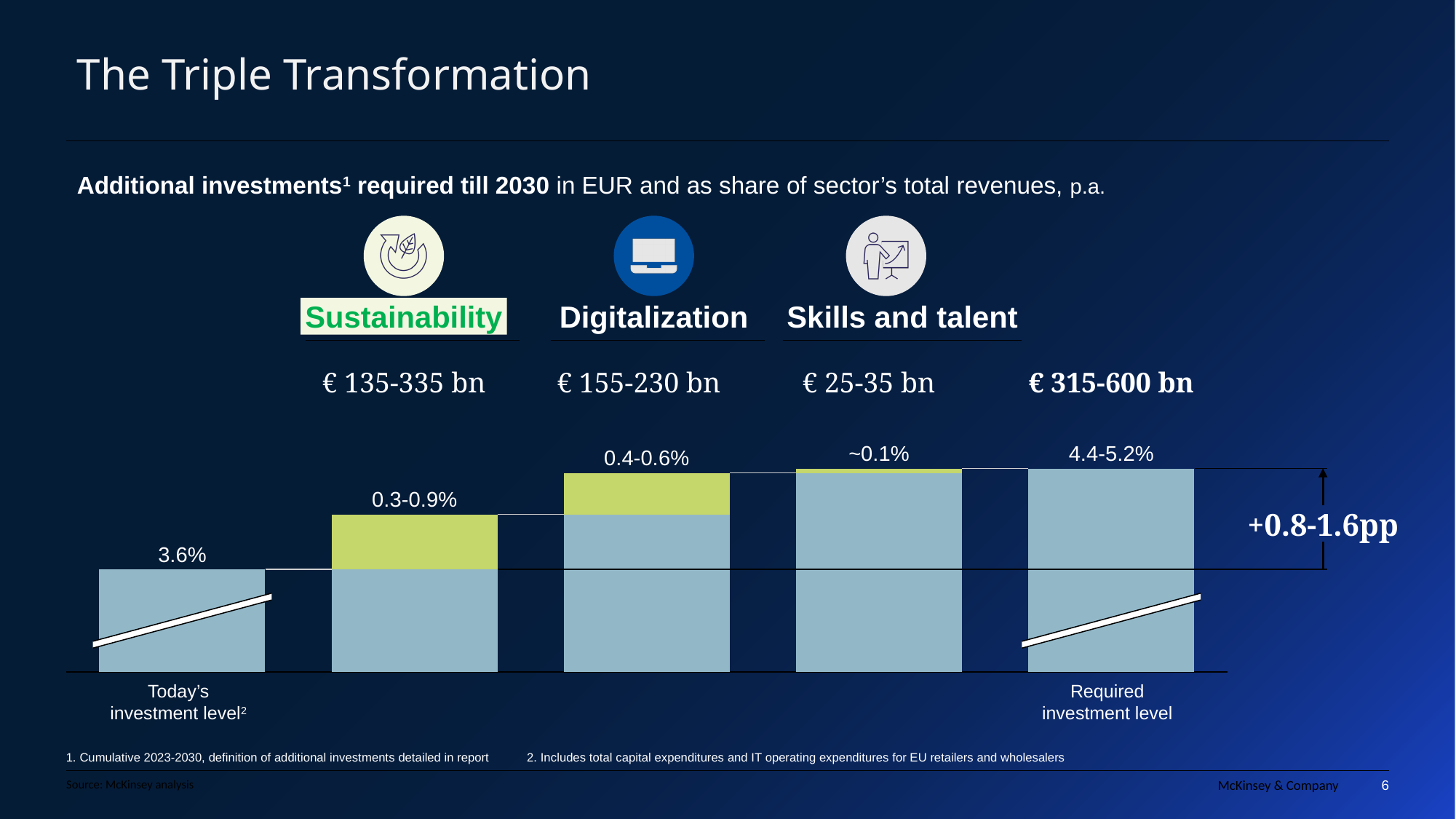
What additional share of revenues is labelled on the Digitalization step of the chart? 0.4-0.6% How many bars are plotted in the chart? 5 What additional share of revenues is labelled on the Sustainability step of the chart? 0.3-0.9% What additional investment in EUR is required for Sustainability? € 135-335 bn What total increase in percentage points is shown between today's and the required investment level? +0.8-1.6pp What additional share of revenues is labelled on the Skills and talent step of the chart? ~0.1% What is the total additional investment in EUR required across all three transformations? € 315-600 bn Which transformation label is highlighted in green on the slide? Sustainability Which of the three transformations has the smallest additional share of revenues in the chart? Skills and talent What is the required investment level as a share of sector revenues shown on the last bar? 4.4-5.2% What is today's investment level as a share of sector revenues? 3.6% What additional investment in EUR is required for Skills and talent? € 25-35 bn